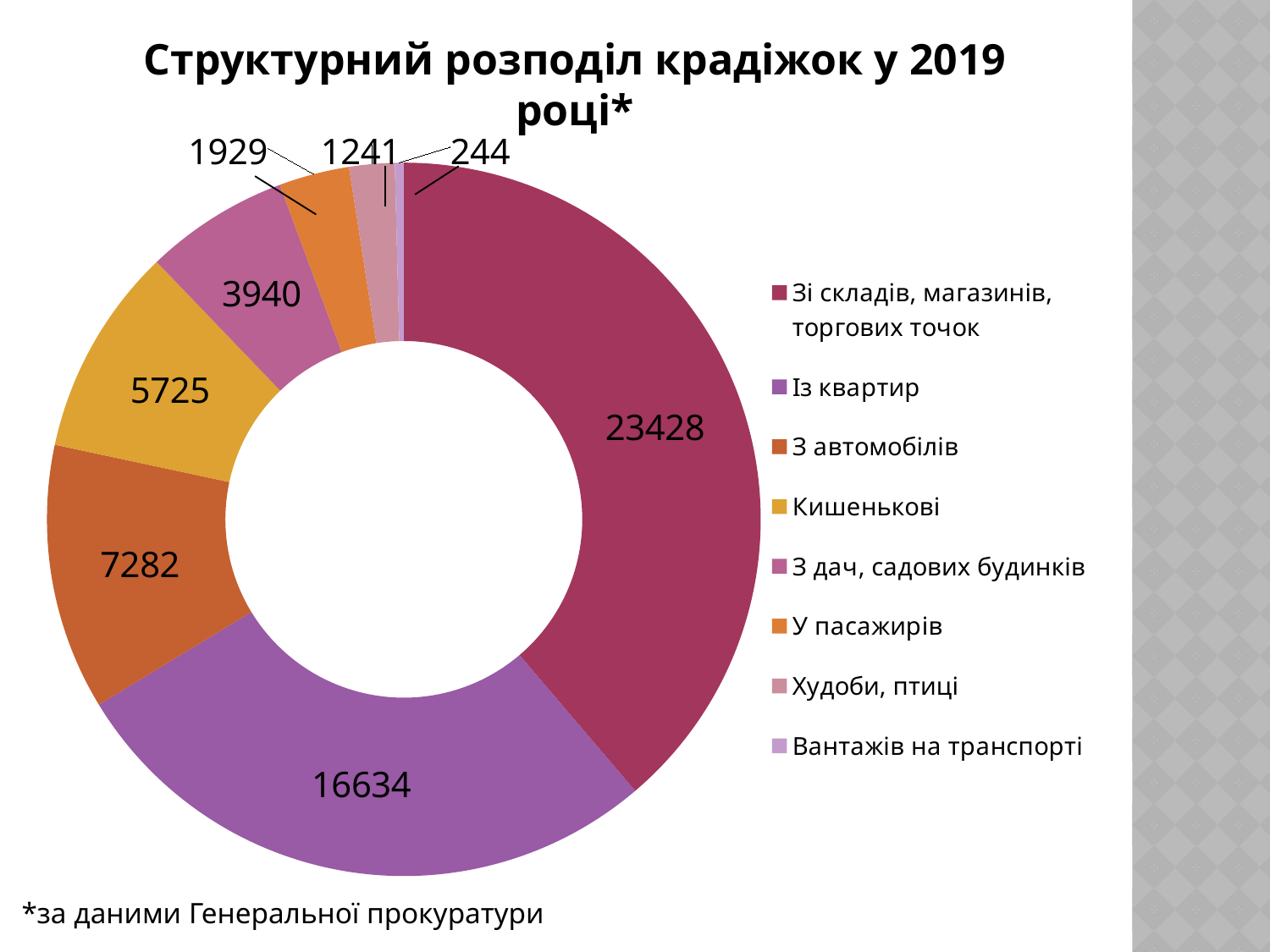
What kind of chart is shown on the slide? doughnut chart What is the difference between the values for 'З автомобілів' and 'Кишенькові'? 1557 What is the value for the category 'Із квартир'? 16634 Which category has the highest value? Зі складів, магазинів, торгових точок Which category has the lowest value? Вантажів на транспорті What is the value for the category 'Зі складів, магазинів, торгових точок'? 23428 What is the value for the category 'Кишенькові'? 5725 What is the value for the category 'Вантажів на транспорті'? 244 Which is larger: the value for 'З дач, садових будинків' or the value for 'У пасажирів'? З дач, садових будинків What is the difference between the values for 'Зі складів, магазинів, торгових точок' and 'Із квартир'? 6794 What is the title of the chart? Структурний розподіл крадіжок у 2019 році* How many categories does the chart show? 8